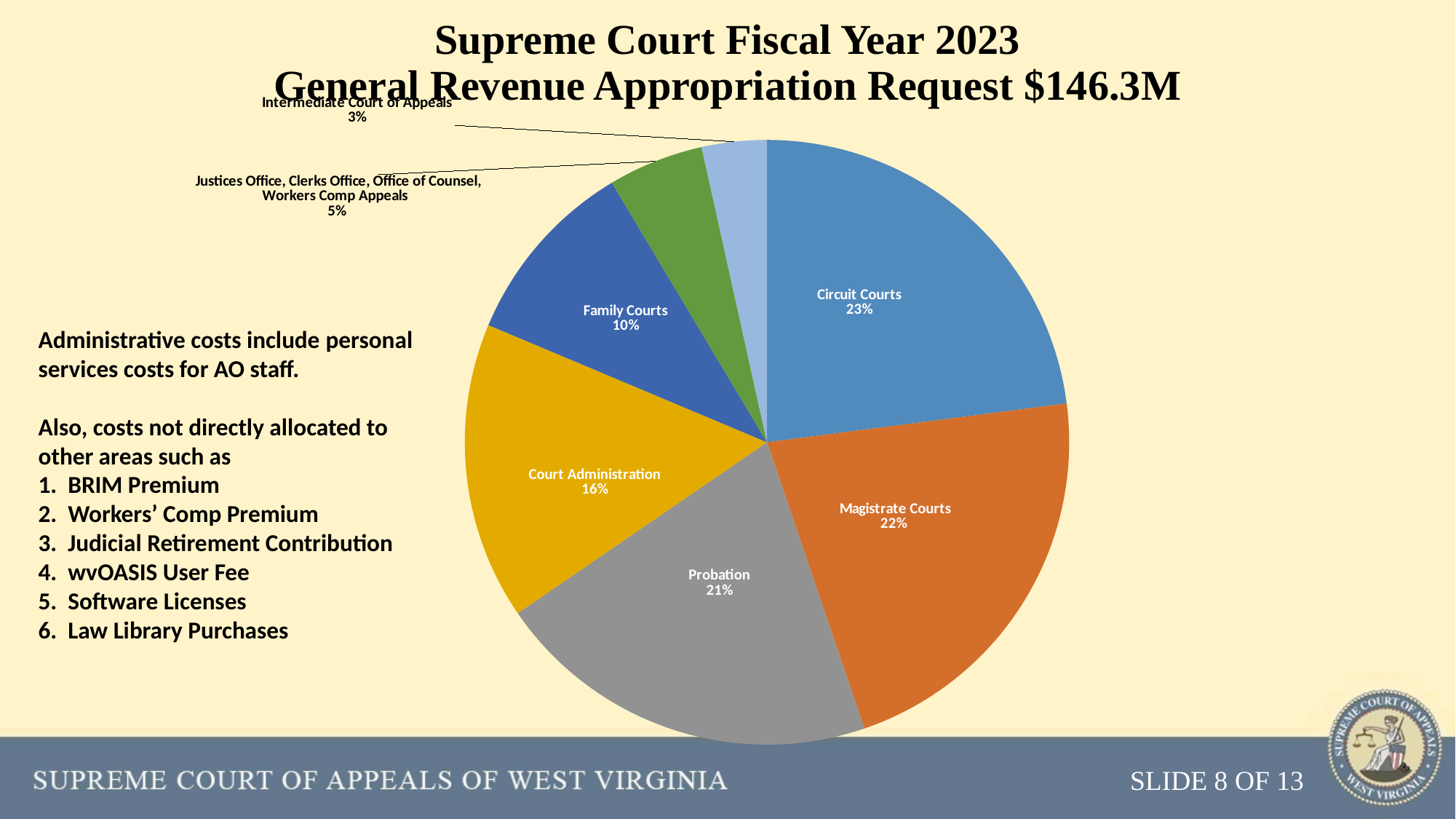
What is the difference in percentage points between Probation and Family Courts? 11 How many slices does the pie chart have? 7 What share of the pie does Circuit Courts represent? 23% Which category has the smallest slice of the pie? Intermediate Court of Appeals What type of chart is shown on the slide? Pie chart What percentage is shown for the Intermediate Court of Appeals? 3% Which category has the largest slice of the pie? Circuit Courts What is the combined percentage of Circuit Courts and Magistrate Courts? 45% Which is larger, the share for Court Administration or the share for Family Courts? Court Administration What percentage is shown for Magistrate Courts? 22% What percentage is shown for Court Administration? 16% What is the total appropriation request amount stated in the chart title? $146.3M